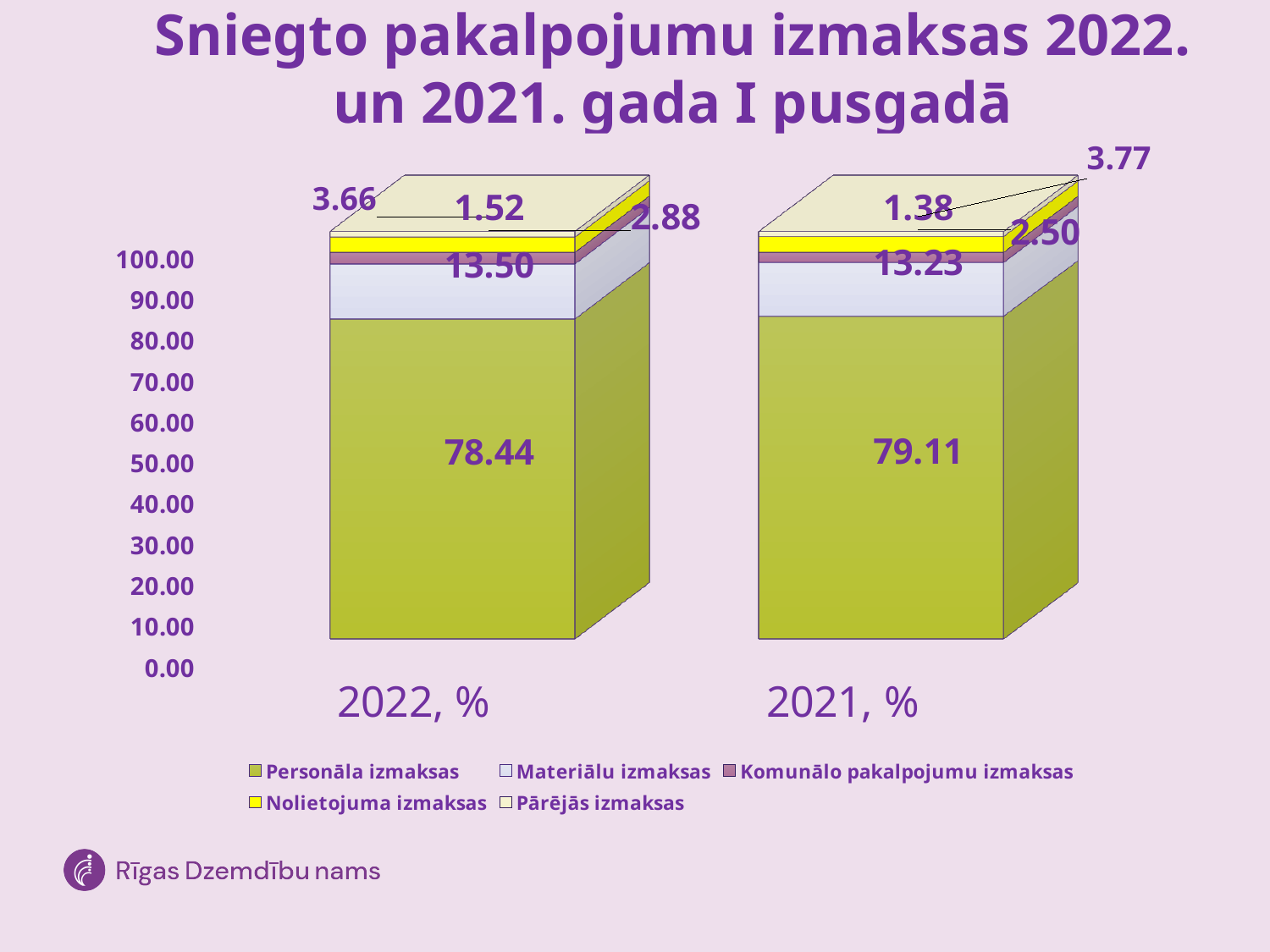
Which series has the largest segment in the 2022, % bar? Personāla izmaksas What kind of chart is shown on the slide? Stacked bar chart What is the value of Personāla izmaksas for 2022, %? 78.44 How many categories (bars) are shown on the x axis? 2 What is the value of Materiālu izmaksas for 2022, %? 13.50 Which year has the larger value for Personāla izmaksas, 2022 or 2021? 2021 How many series does the legend list? 5 What is the difference between the Materiālu izmaksas values for 2022 and 2021? 0.27 What is the value of Materiālu izmaksas for 2021, %? 13.23 What is the difference between the Personāla izmaksas values for 2021 and 2022? 0.67 Is the value for Personāla izmaksas in 2022 greater or less than 70.00? greater What is the value of Personāla izmaksas for 2021, %? 79.11